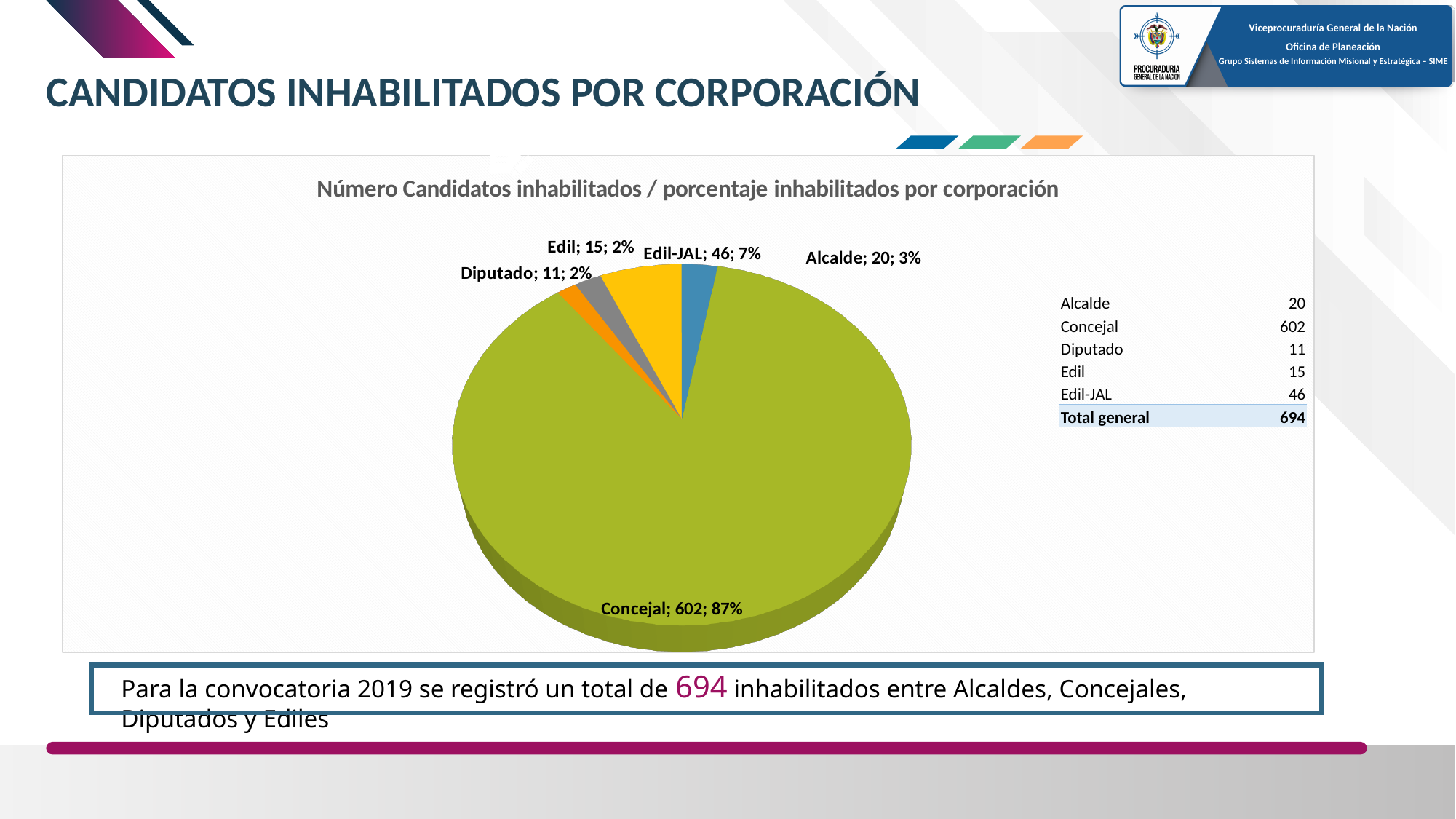
What is the difference between the values for Edil-JAL and Alcalde? 26 What is the value for Alcalde? 20 What percentage share of the pie does Edil-JAL have? 7% What is the total (Total general) of all categories? 694 What kind of chart is shown on the slide? Pie chart Which category has the largest slice of the pie? Concejal How many candidates are shown for Concejal? 602 How many categories are shown in the pie chart? 5 What percentage share of the pie does Concejal have? 87% Which is larger, the value for Edil or the value for Diputado? Edil Which category has the smallest slice of the pie? Diputado What is the value for Edil-JAL? 46